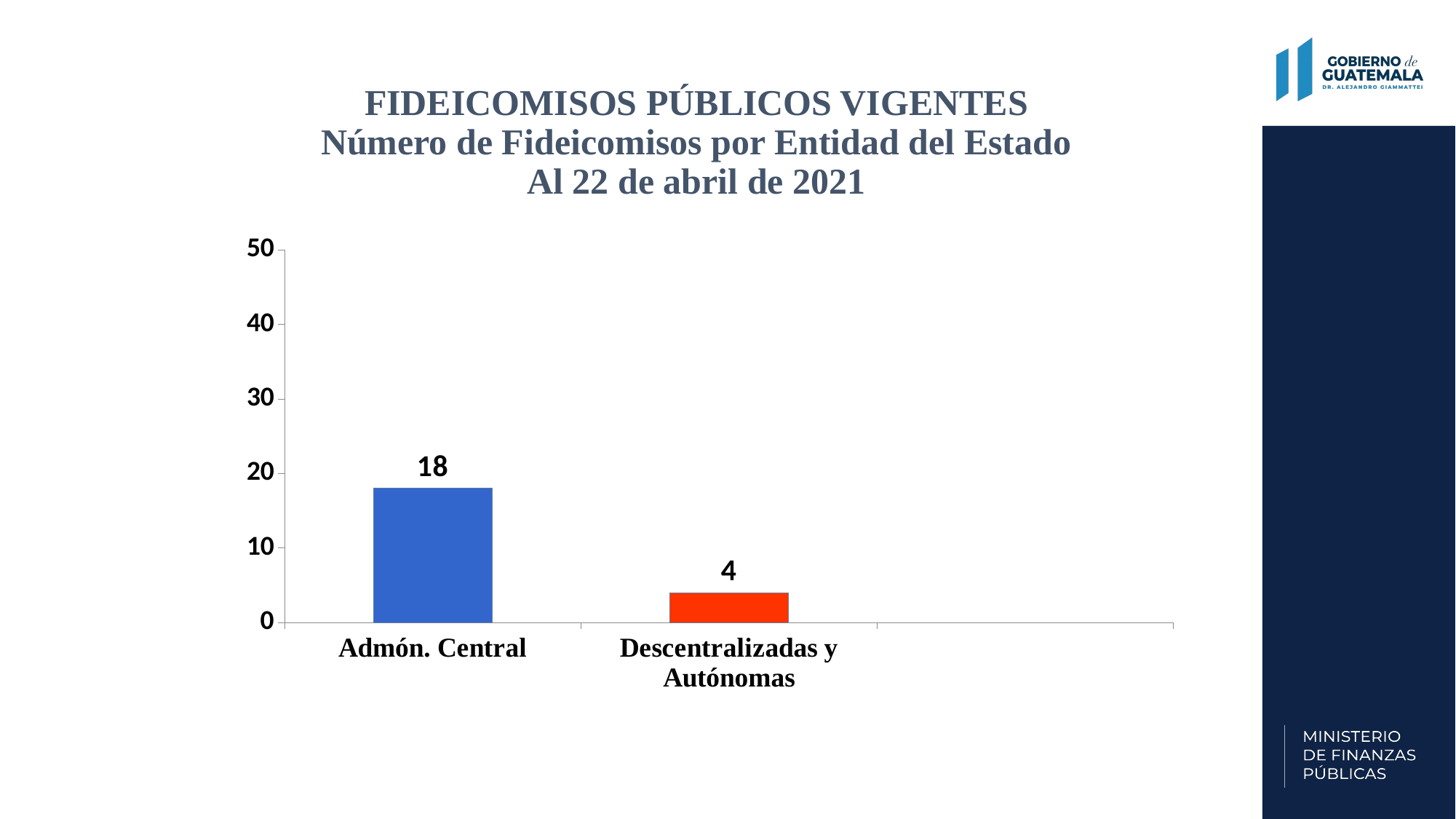
What kind of chart is shown on the slide? bar chart Which category has the highest value? Admón. Central What is the value for Descentralizadas y Autónomas? 4 Is the value for Admón. Central greater or less than 20? less What is the total of the two values shown in the chart? 22 Is the value for Descentralizadas y Autónomas greater or less than 10? less What colour is the bar for Descentralizadas y Autónomas? red Which is larger, the value for Admón. Central or the value for Descentralizadas y Autónomas? Admón. Central How many categories are shown in the chart? 2 Which category has the lowest value? Descentralizadas y Autónomas What is the value for Admón. Central? 18 What is the difference between the values for Admón. Central and Descentralizadas y Autónomas? 14